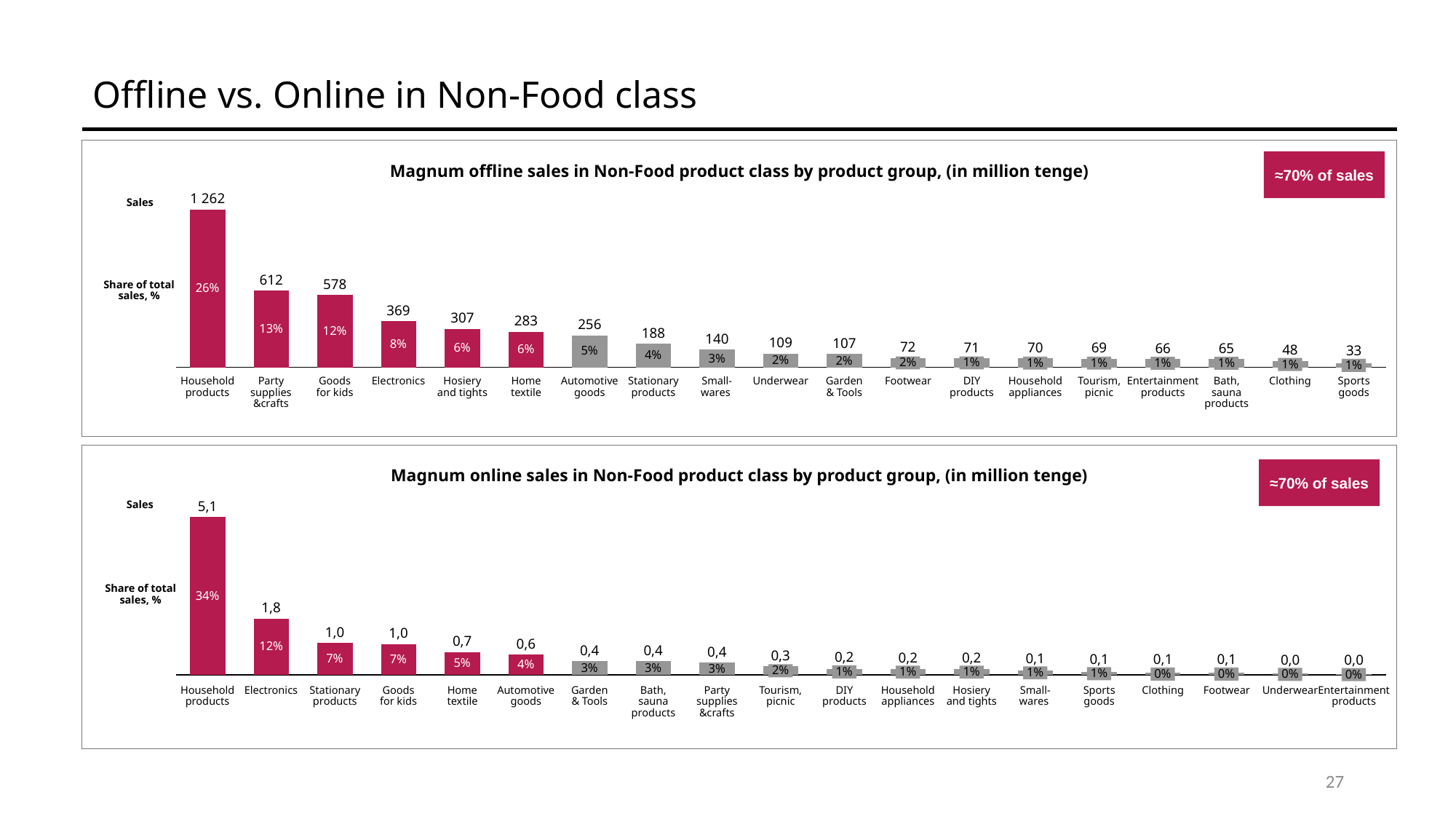
In the Magnum online sales chart, what are the sales for Electronics? 1,8 In the Magnum offline sales chart, what are the sales for Household products? 1 262 How many product groups are shown in the Magnum offline sales chart? 19 In the Magnum offline sales chart, which has higher sales, Electronics or Automotive goods? Electronics In the Magnum online sales chart, what share of total sales do Household products account for? 34% In the Magnum offline sales chart, which product group has the lowest sales? Sports goods In the Magnum offline sales chart, what is the difference in sales between Household products and Party supplies & crafts? 650 In the Magnum online sales chart, which has higher sales, Household products or Electronics? Household products What kind of chart is the Magnum online sales chart? Bar chart In the Magnum offline sales chart, what share of total sales do Party supplies & crafts account for? 13% In the Magnum offline sales chart, do the sales values rise or fall from left to right? Fall In the Magnum online sales chart, which product group has the highest sales? Household products